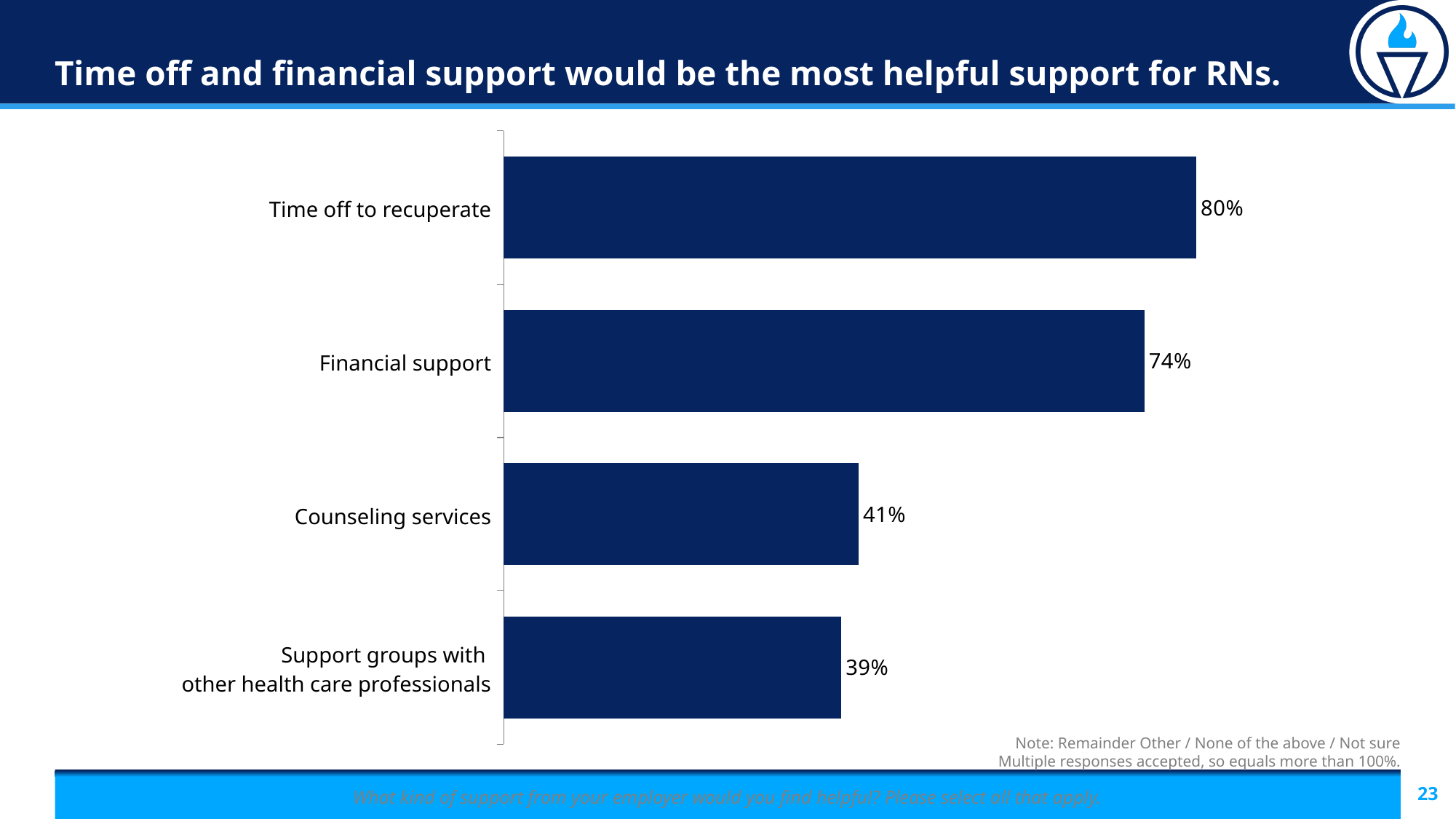
What is the title of the slide? Time off and financial support would be the most helpful support for RNs. Which type of support has the highest percentage? Time off to recuperate What is the value shown for financial support? 74% What is the difference in percentage points between time off to recuperate and financial support? 6 What is the value for support groups with other health care professionals? 39% Which type of support has the lowest percentage? Support groups with other health care professionals What kind of chart is shown on the slide? Bar chart What percentage is shown for counseling services? 41% What percentage of RNs selected time off to recuperate as helpful support? 80% Which is larger, the value for counseling services or the value for support groups with other health care professionals? Counseling services How many types of support are shown in the chart? 4 What is the difference in percentage points between financial support and counseling services? 33